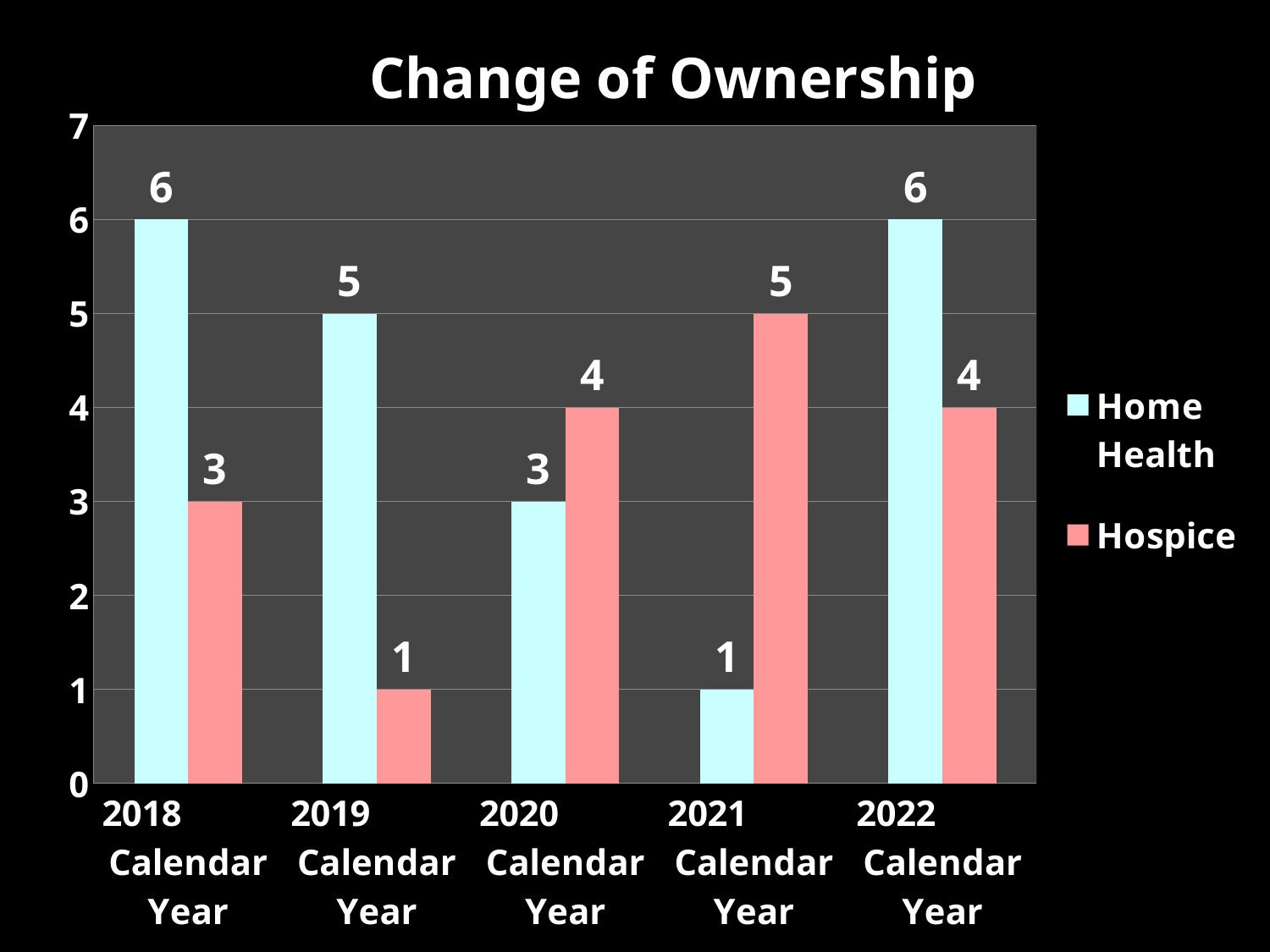
Which calendar year has the highest Hospice value? 2021 Calendar Year What is the Hospice value for 2019 Calendar Year? 1 How many calendar years are shown on the x axis? 5 What is the Hospice value for 2021 Calendar Year? 5 Which is larger for 2020 Calendar Year, Home Health or Hospice? Hospice What kind of chart is shown on the slide? Bar chart What is the title of the chart? Change of Ownership Which calendar year has the lowest Home Health value? 2021 Calendar Year What is the Home Health value for 2018 Calendar Year? 6 What is the difference between the Home Health and Hospice values for 2019 Calendar Year? 4 How many series does the legend list? 2 Which series is shown in pink/red? Hospice